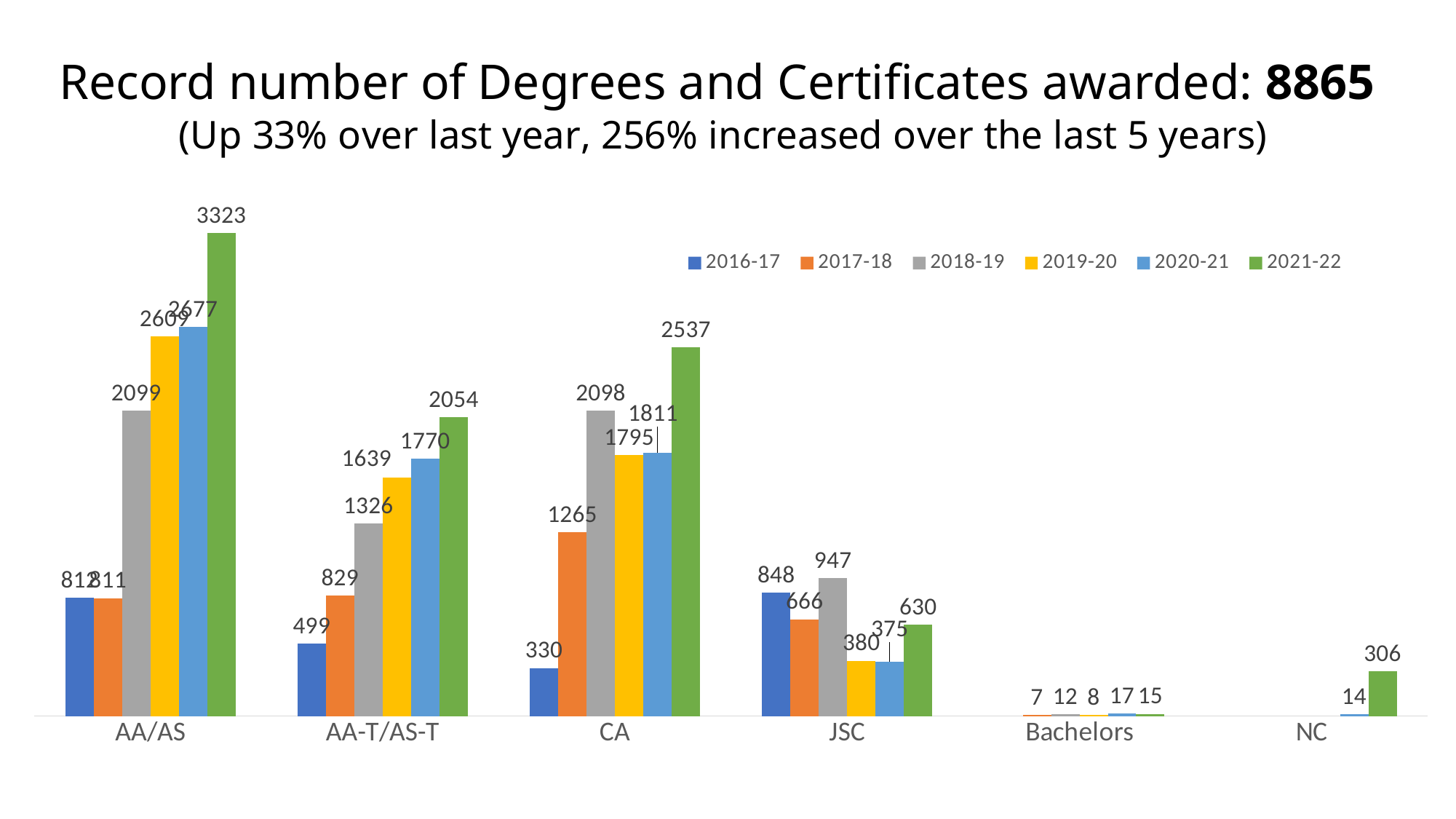
Do the values for AA-T/AS-T rise or fall from 2016-17 to 2021-22? rise What is the value for NC in 2021-22? 306 What is the value for JSC in 2018-19? 947 For JSC, which year has the larger value, 2016-17 or 2017-18? 2016-17 What is the difference between the CA values for 2021-22 and 2018-19? 439 Which category has the highest value in 2021-22? AA/AS What is the value for AA/AS in 2021-22? 3323 How many series does the legend list? 6 How many categories are shown on the x axis? 6 Which category has the lowest value in 2021-22? Bachelors What is the value for AA-T/AS-T in 2016-17? 499 What is the value for CA in 2021-22? 2537